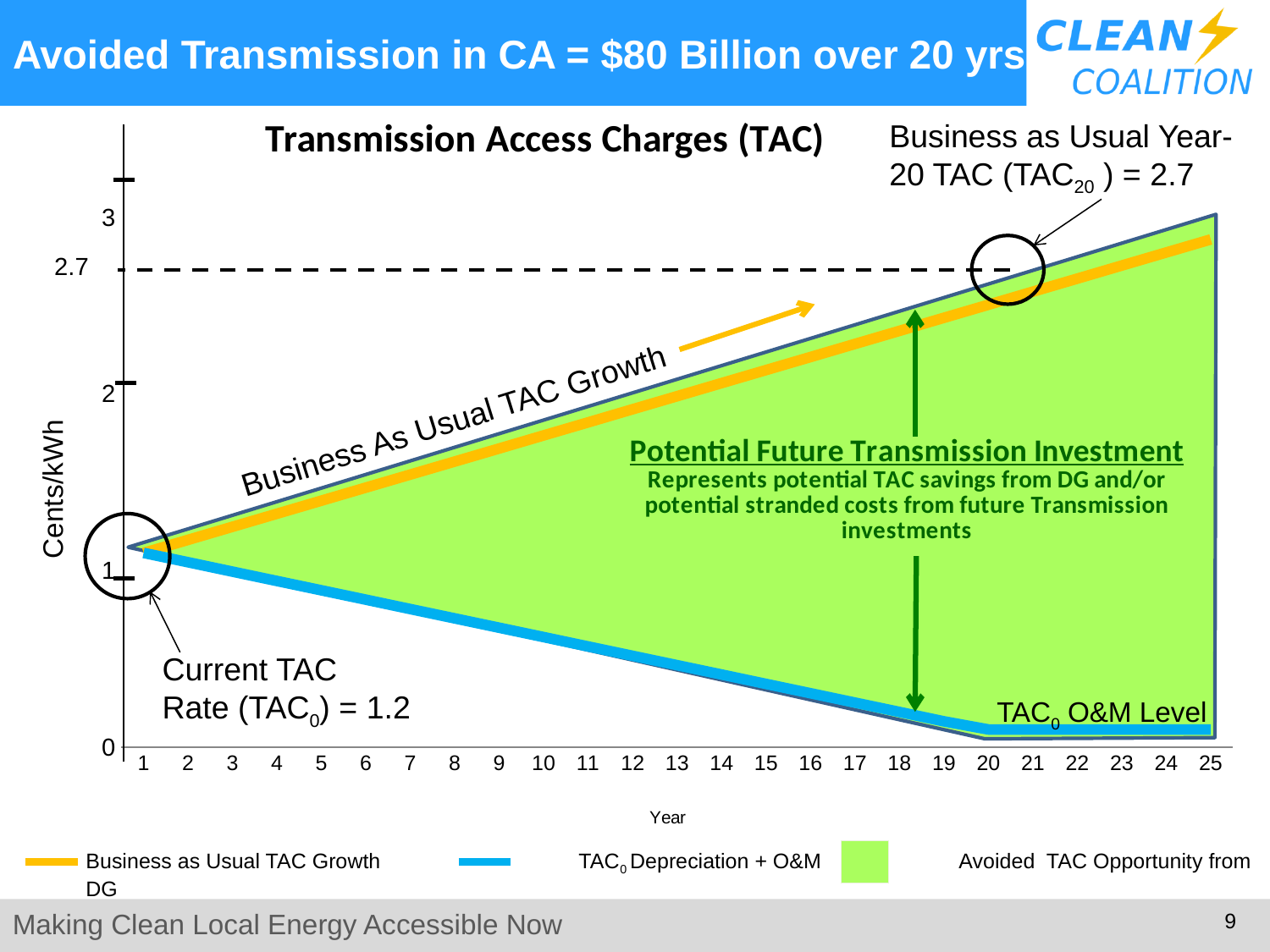
Does the Business as Usual TAC Growth line rise or fall over the years? rise What is the difference between the Business as Usual Year-20 TAC and the Current TAC Rate? 1.5 At year 20, which is larger: Business as Usual TAC Growth or TAC0 Depreciation + O&M? Business as Usual TAC Growth What type of chart is shown on the slide? line chart Is the TAC0 Depreciation + O&M value at year 15 greater or less than 1? less Is the Business as Usual TAC Growth value at year 5 greater or less than 2? less Does the TAC0 Depreciation + O&M line rise or fall over the years? fall How many years are shown on the x axis of the chart? 25 How many series does the chart legend list? 3 What is the title of the chart? Transmission Access Charges (TAC) What is the Current TAC Rate (TAC0) shown on the chart? 1.2 What is the Business as Usual Year-20 TAC (TAC20) value shown on the chart? 2.7